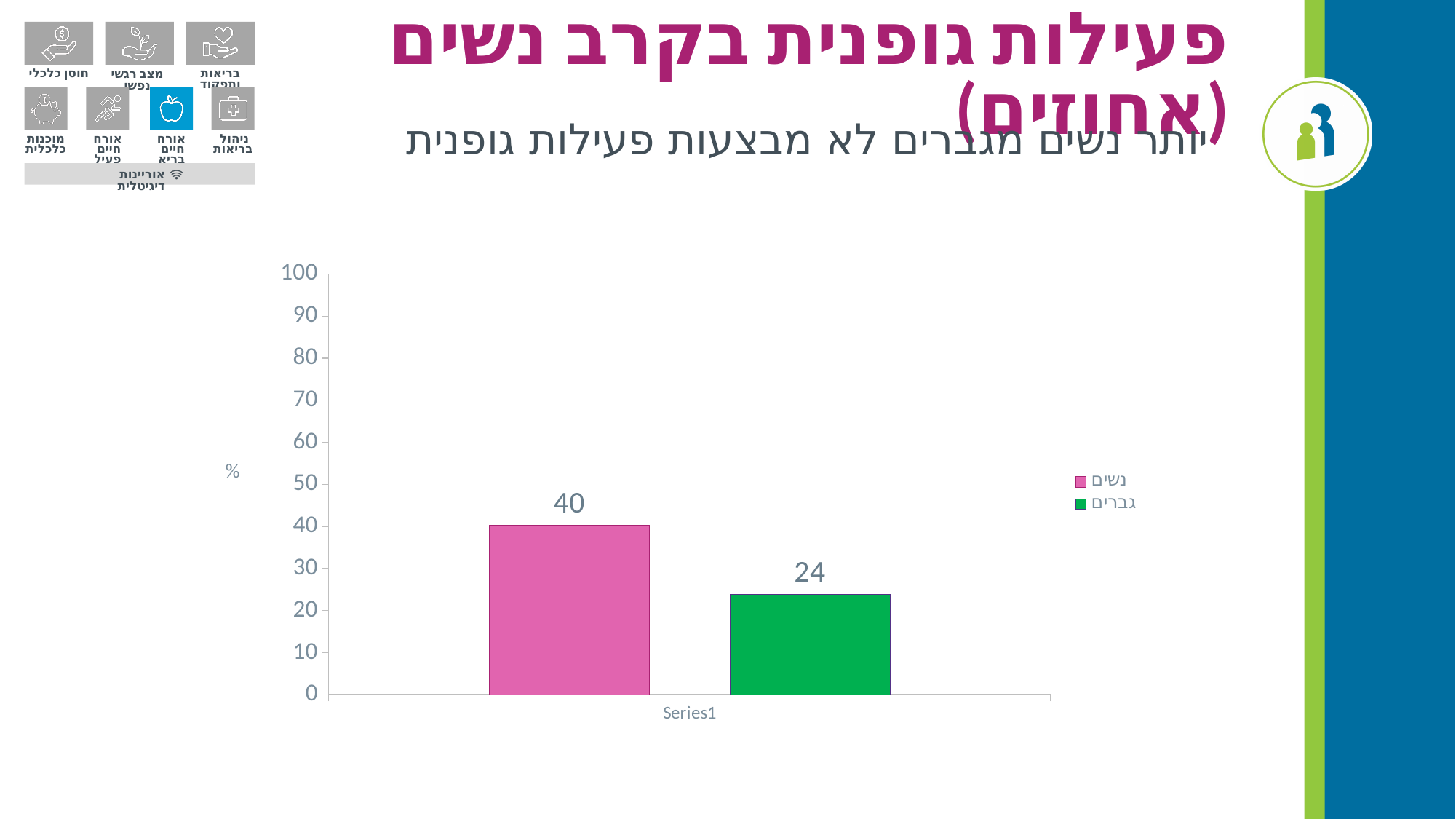
What is the label on the vertical axis of the chart? % What is the value for גברים (men) in the chart? 24 Which group has the higher value in the chart, נשים or גברים? נשים Is the value for נשים larger or smaller than the value for גברים? larger What kind of chart is shown on the slide? bar chart How many bars are plotted in the chart? 2 Is the value for גברים greater or less than 30? less How many series does the legend list? 2 What is the difference between the value for נשים and the value for גברים? 16 What colour is the bar for נשים? pink What is the value for נשים (women) in the chart? 40 Which group has the lower value in the chart? גברים